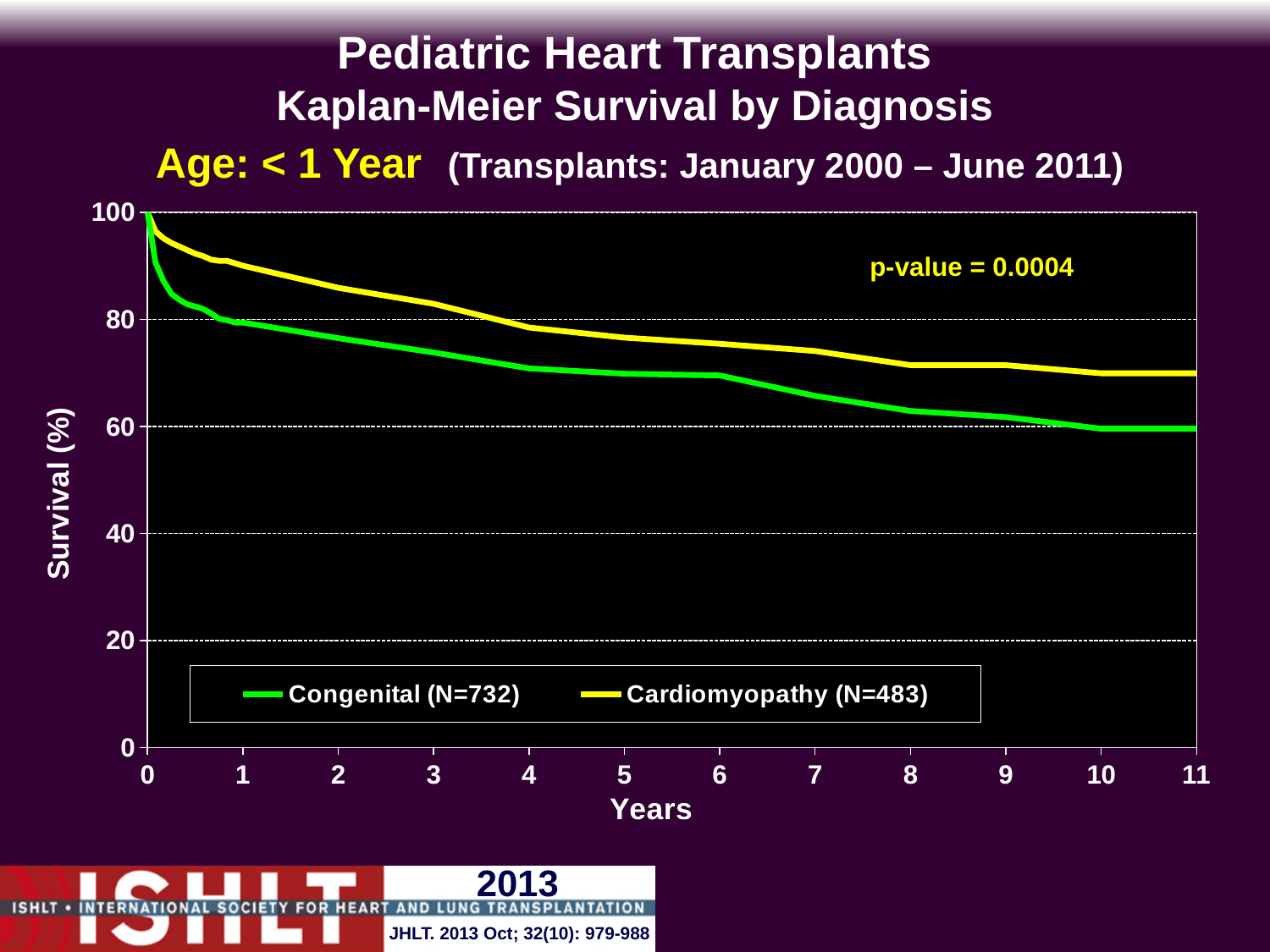
Is the survival value for Cardiomyopathy at 2 years greater or less than 80? greater Is the survival value for Congenital at 5 years greater or less than 80? less What is the N for the Congenital group shown in the legend? N=732 Do the survival curves rise or fall as years increase? Fall What kind of chart is shown on the slide? Line chart Is the survival value for Cardiomyopathy at 5 years greater or less than 80? less At 5 years, which series has higher survival, Congenital or Cardiomyopathy? Cardiomyopathy How many series does the legend list? 2 What p-value is printed on the chart? p-value = 0.0004